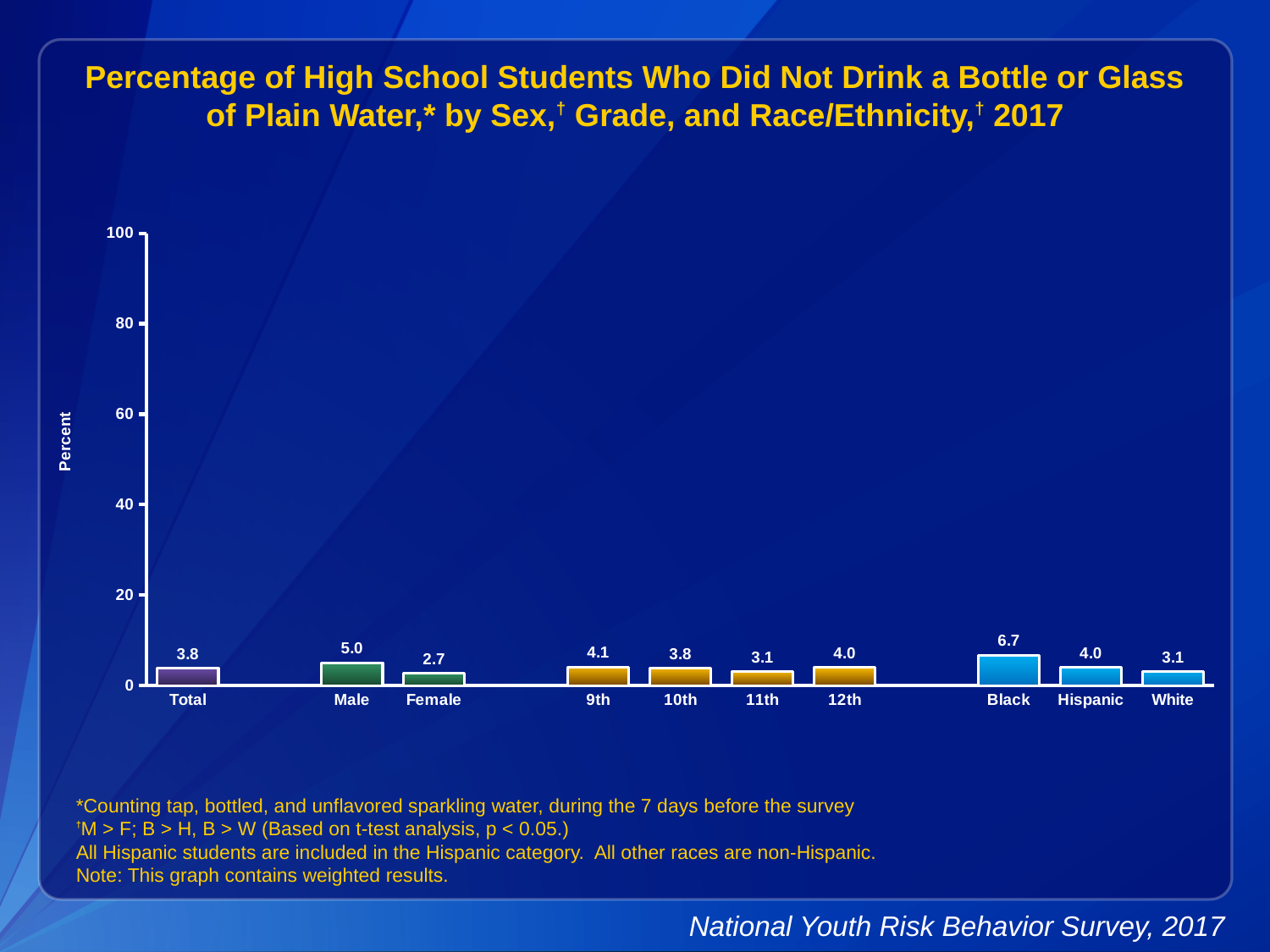
What is the difference between the values for Black and White? 3.6 What is the label of the y axis? Percent What is the value for Total? 3.8 What kind of chart is this? bar chart What is the difference between the values for Male and Female? 2.3 Which category has the lowest value? Female How many categories are shown on the x axis? 10 What is the value for Black? 6.7 Which category has the highest value? Black Is the value for Hispanic greater or less than 20? less Which is larger, the value for 9th or the value for 11th? 9th What is the value for Male? 5.0